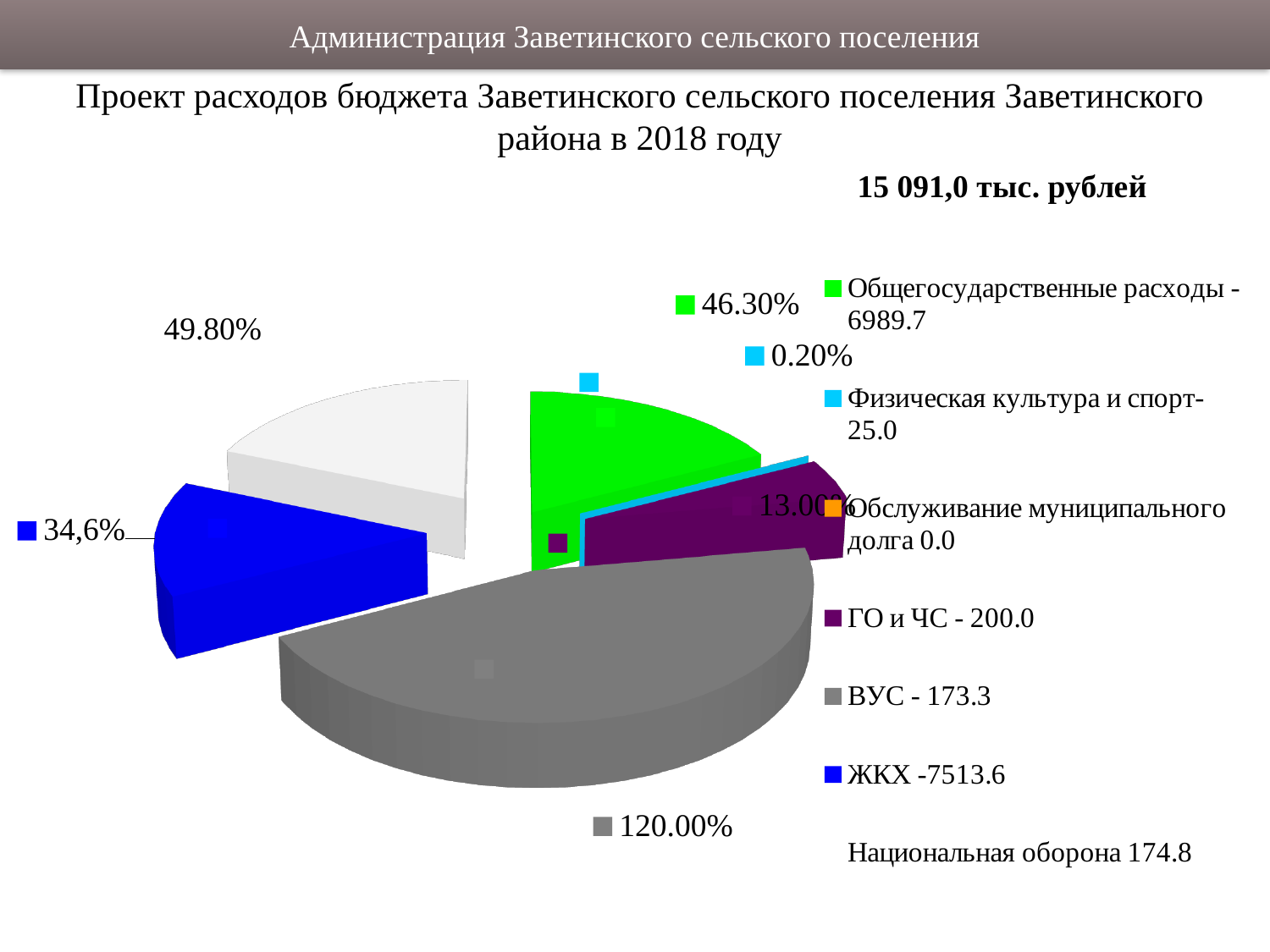
What value is given in the legend for ЖКХ? 7513.6 What value is given in the legend for Физическая культура и спорт? 25.0 Which has the larger legend value, ВУС or Национальная оборона? Национальная оборона What value is given in the legend for ГО и ЧС? 200.0 What value is given in the legend for Общегосударственные расходы? 6989.7 Which legend entry has the smallest value? Обслуживание муниципального долга Which legend entry has the largest value? ЖКХ How many entries does the chart legend list? 7 What kind of chart is shown on the slide? pie chart What percentage label is shown on the green slice? 46.30% What total amount is printed above the chart? 15 091,0 тыс. рублей What is the difference between the legend values for ЖКХ and Общегосударственные расходы? 523.9